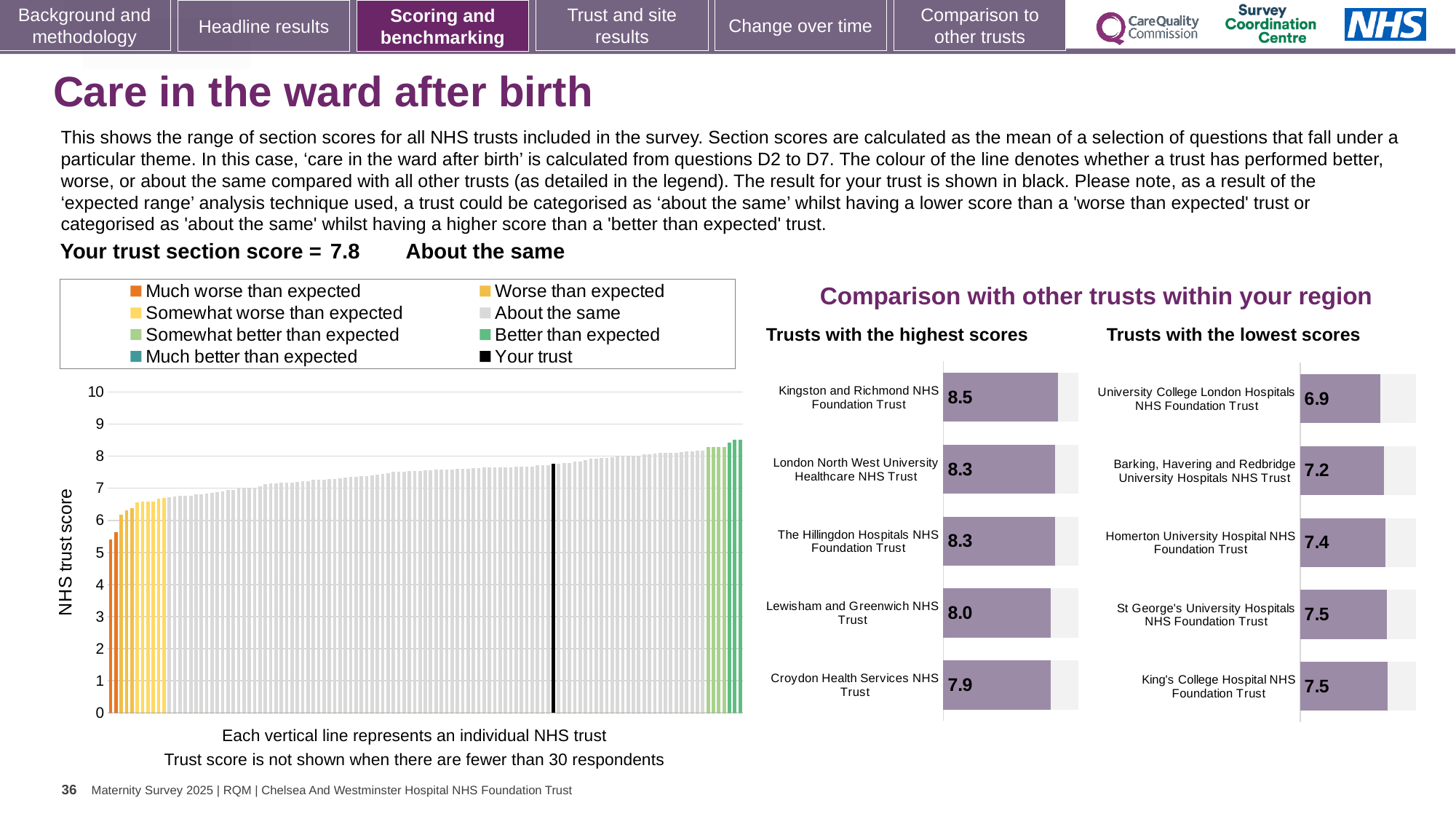
In the 'Trusts with the highest scores' chart, which trust has the lowest score shown? Croydon Health Services NHS Trust In the large chart on the left, do the trust scores rise or fall from left to right? Rise In the 'Trusts with the highest scores' chart, what is the difference between the scores of Kingston and Richmond NHS Foundation Trust and Croydon Health Services NHS Trust? 0.6 In the 'Trusts with the lowest scores' chart, what is the score for University College London Hospitals NHS Foundation Trust? 6.9 How many entries does the legend above the large chart on the left list? 8 In the 'Trusts with the highest scores' chart, what is the score for Kingston and Richmond NHS Foundation Trust? 8.5 In the large chart on the left, is the value for the black 'Your trust' bar greater or less than 7? greater What kind of chart is the large chart on the left with the y-axis labelled 'NHS trust score'? Bar chart In the 'Trusts with the lowest scores' chart, what is the difference between the scores of Homerton University Hospital NHS Foundation Trust and University College London Hospitals NHS Foundation Trust? 0.5 In the 'Trusts with the lowest scores' chart, which has the larger score: Barking, Havering and Redbridge University Hospitals NHS Trust or Homerton University Hospital NHS Foundation Trust? Homerton University Hospital NHS Foundation Trust In the 'Trusts with the highest scores' chart, how many trusts are shown? 5 In the 'Trusts with the lowest scores' chart, which trust has the highest score shown? St George's University Hospitals NHS Foundation Trust and King's College Hospital NHS Foundation Trust (both 7.5)